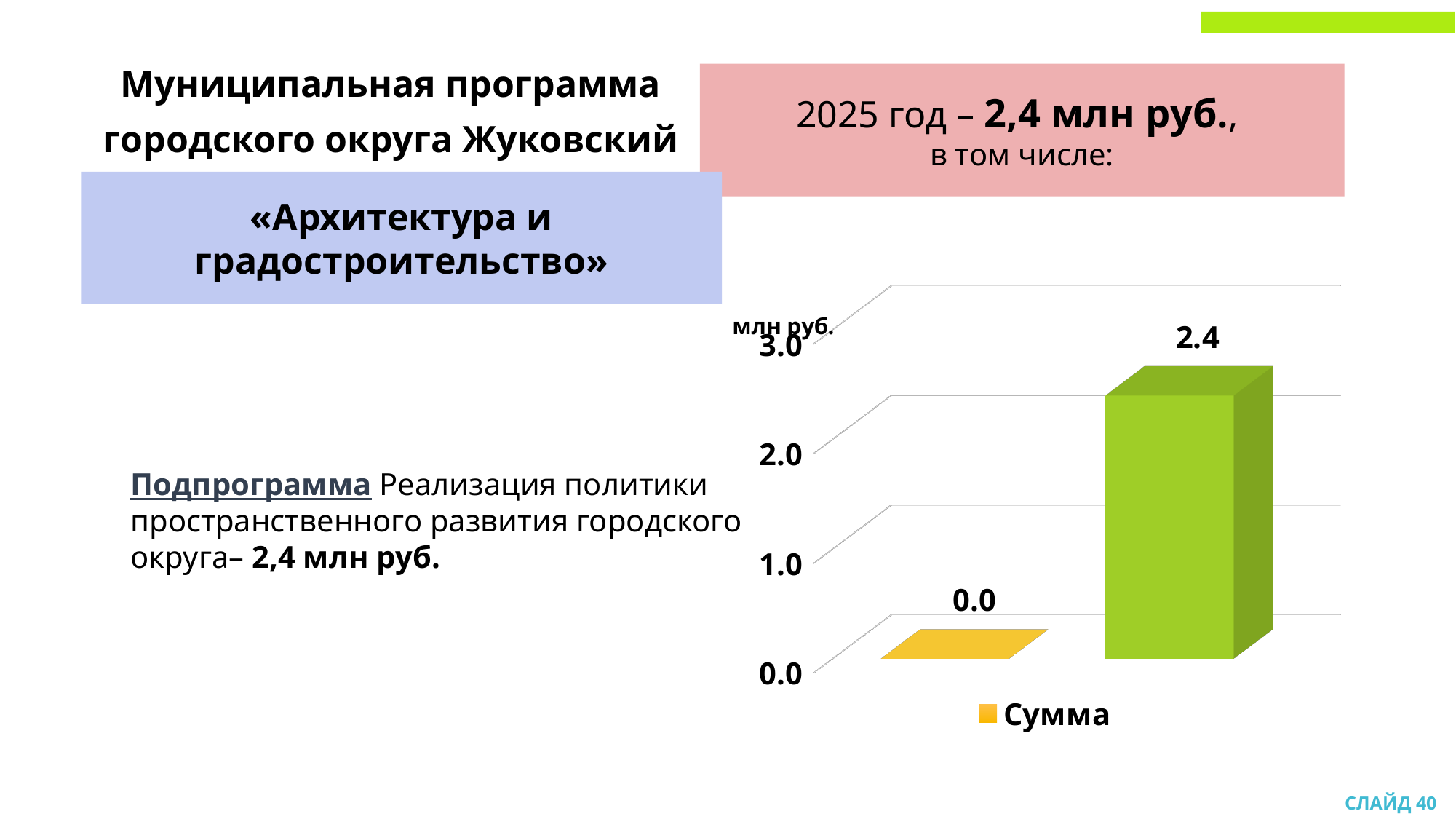
How many series does the chart legend list? 1 What kind of chart is shown on the slide? bar chart Is the value of the green bar greater or less than 2.0? greater What is the value shown on the yellow bar in the chart? 0.0 Which bar is taller, the green one or the yellow one? the green one How many bars are plotted in the chart? 2 What is the name of the series listed in the chart legend? Сумма What is the value shown on the green bar in the chart? 2.4 What is the lowest value labelled in the chart? 0.0 What is the difference between the green bar's value and the yellow bar's value? 2.4 What unit is shown on the chart's vertical axis? млн руб. What is the highest value labelled in the chart? 2.4